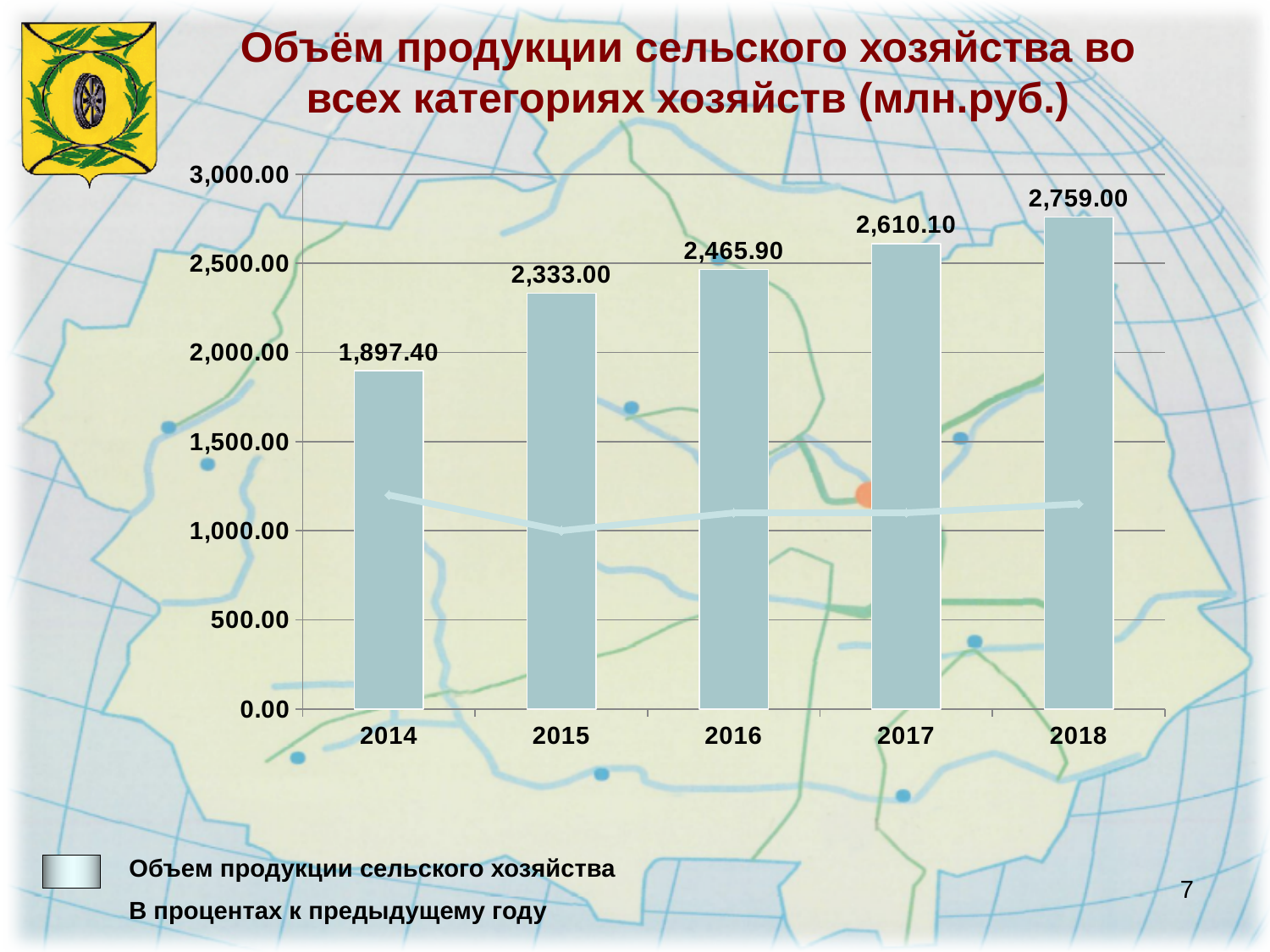
Which is larger, the bar value for 2017 or for 2015? 2017 What is the difference between the bar values for 2018 and 2014? 861.60 What is the value of the bar for 2016? 2,465.90 Which year has the lowest bar value? 2014 Is the bar value for 2014 greater or less than 2,000.00? less Do the bar values rise or fall from 2014 to 2018? rise What is the difference between the bar values for 2015 and 2014? 435.60 How many years are shown on the x axis? 5 Which year has the highest bar value? 2018 How many series does the legend list? 2 What is the value of the bar for 2018? 2,759.00 What is the value of the bar for 2014? 1,897.40